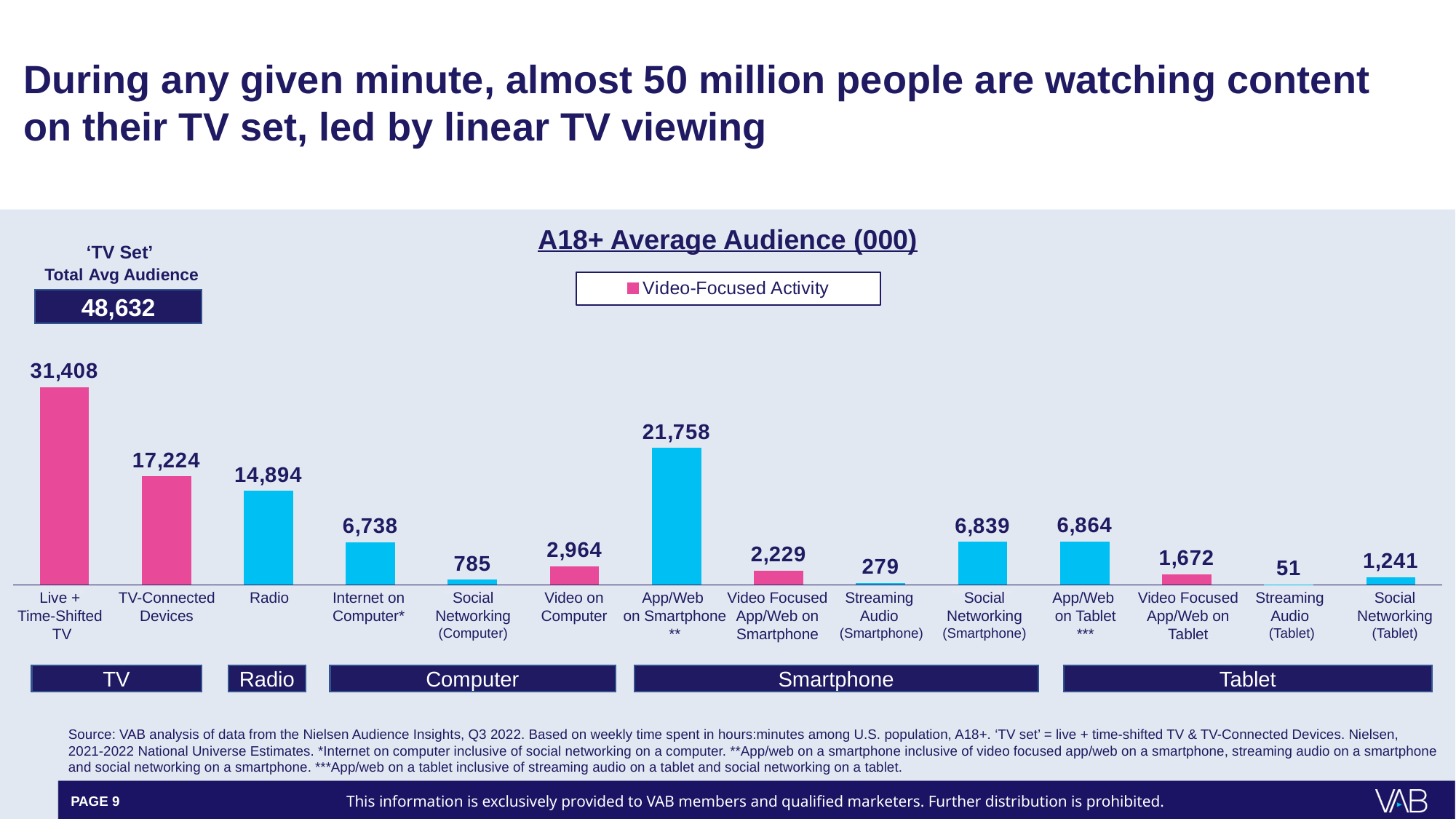
Which category has the lowest average audience? Streaming Audio (Tablet) What is the value shown for App/Web on Smartphone? 21,758 What is the value shown for Streaming Audio (Tablet)? 51 How many categories are plotted in the chart? 14 Which category has the highest average audience? Live + Time-Shifted TV What is the difference between Live + Time-Shifted TV and TV-Connected Devices? 14,184 What is the 'TV Set' Total Avg Audience shown on the slide? 48,632 Which is larger, Video on Computer or Video Focused App/Web on Smartphone? Video on Computer What is the value shown for Social Networking (Computer)? 785 What is the difference between App/Web on Smartphone and Radio? 6,864 What is the A18+ average audience (000) for Live + Time-Shifted TV? 31,408 What kind of chart is shown on the slide? Bar chart